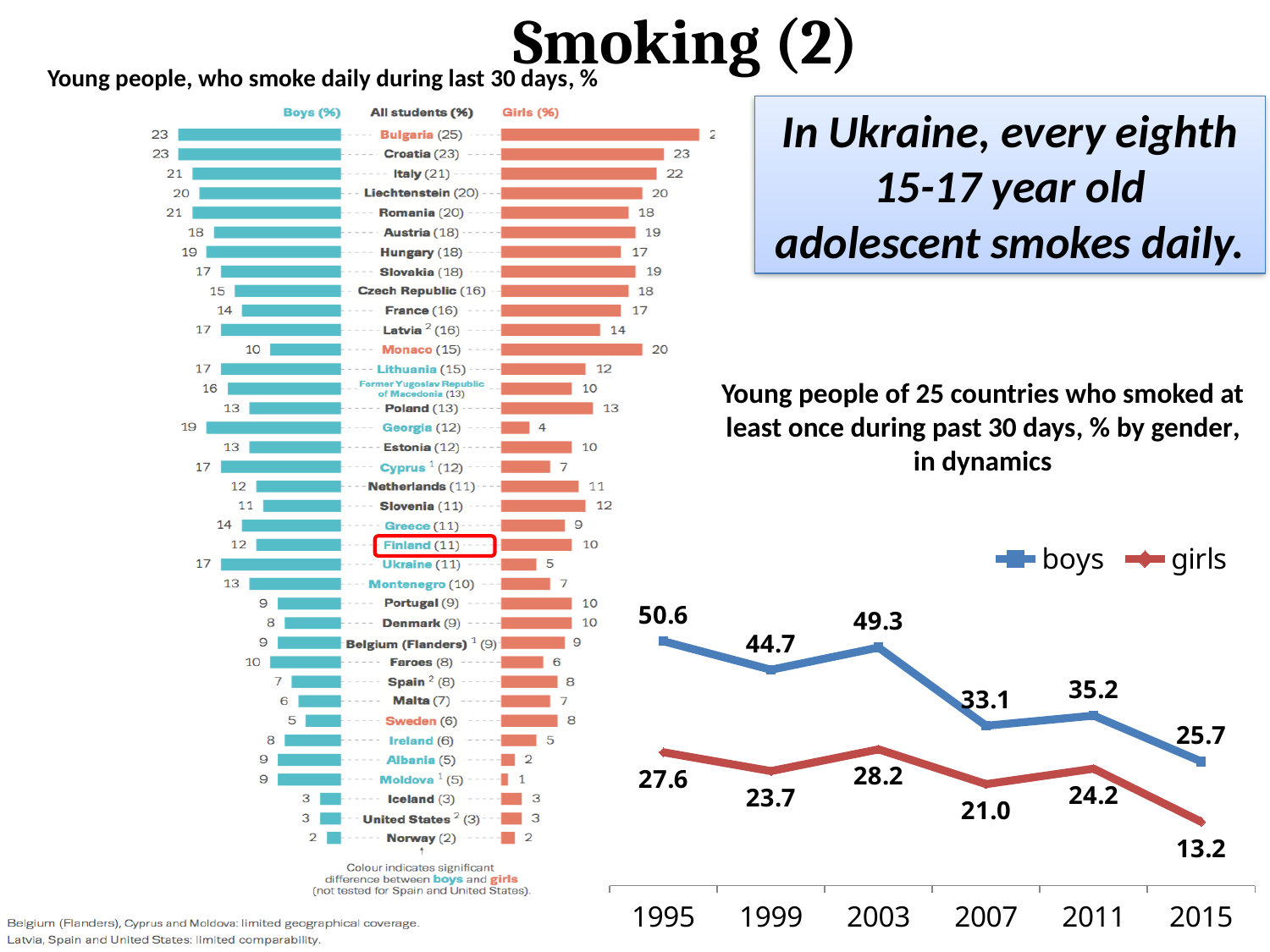
In the line chart on the right, how many series does the legend list? 2 In the line chart on the right, in which year is the value for girls lowest? 2015 In the line chart on the right, in which year is the value for boys highest? 1995 In the bar chart on the left, what is the Girls (%) value for Ukraine? 5 In the line chart on the right, what is the value for boys in 1995? 50.6 In the line chart on the right, what is the difference between boys and girls in 2007? 12.1 In the line chart on the right, what is the value for girls in 2015? 13.2 In the bar chart on the left, what is the Boys (%) value for Ukraine? 17 In the line chart on the right, how many years are plotted on the x axis? 6 In the bar chart on the left, which is larger for Georgia, the Boys (%) value or the Girls (%) value? Boys (%) What kind of chart is the chart on the right of the slide? line chart In the line chart on the right, do the values for boys rise or fall overall from 1995 to 2015? fall